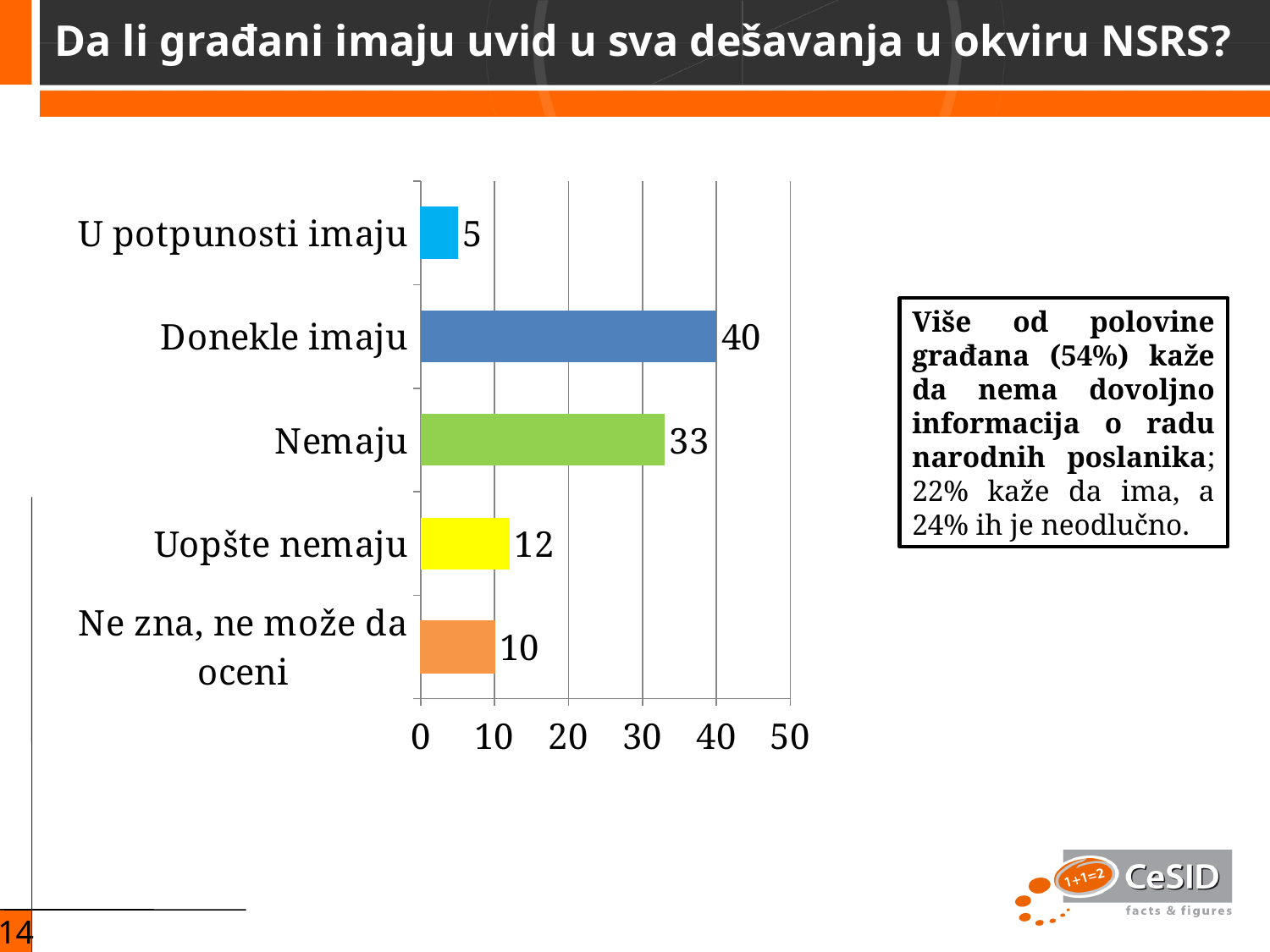
How many categories are shown in the chart? 5 What is the difference between the values for "Donekle imaju" and "Nemaju"? 7 What is the value for "Ne zna, ne može da oceni"? 10 What is the value for "Uopšte nemaju"? 12 What kind of chart is shown on the slide? bar chart What colour is the bar for "Nemaju"? green What is the value for "Nemaju"? 33 Which category has the lowest value? U potpunosti imaju What is the value for "Donekle imaju"? 40 Is the value for "Nemaju" greater or less than 30? greater Which is larger, the value for "Uopšte nemaju" or the value for "Ne zna, ne može da oceni"? Uopšte nemaju Which category has the highest value? Donekle imaju